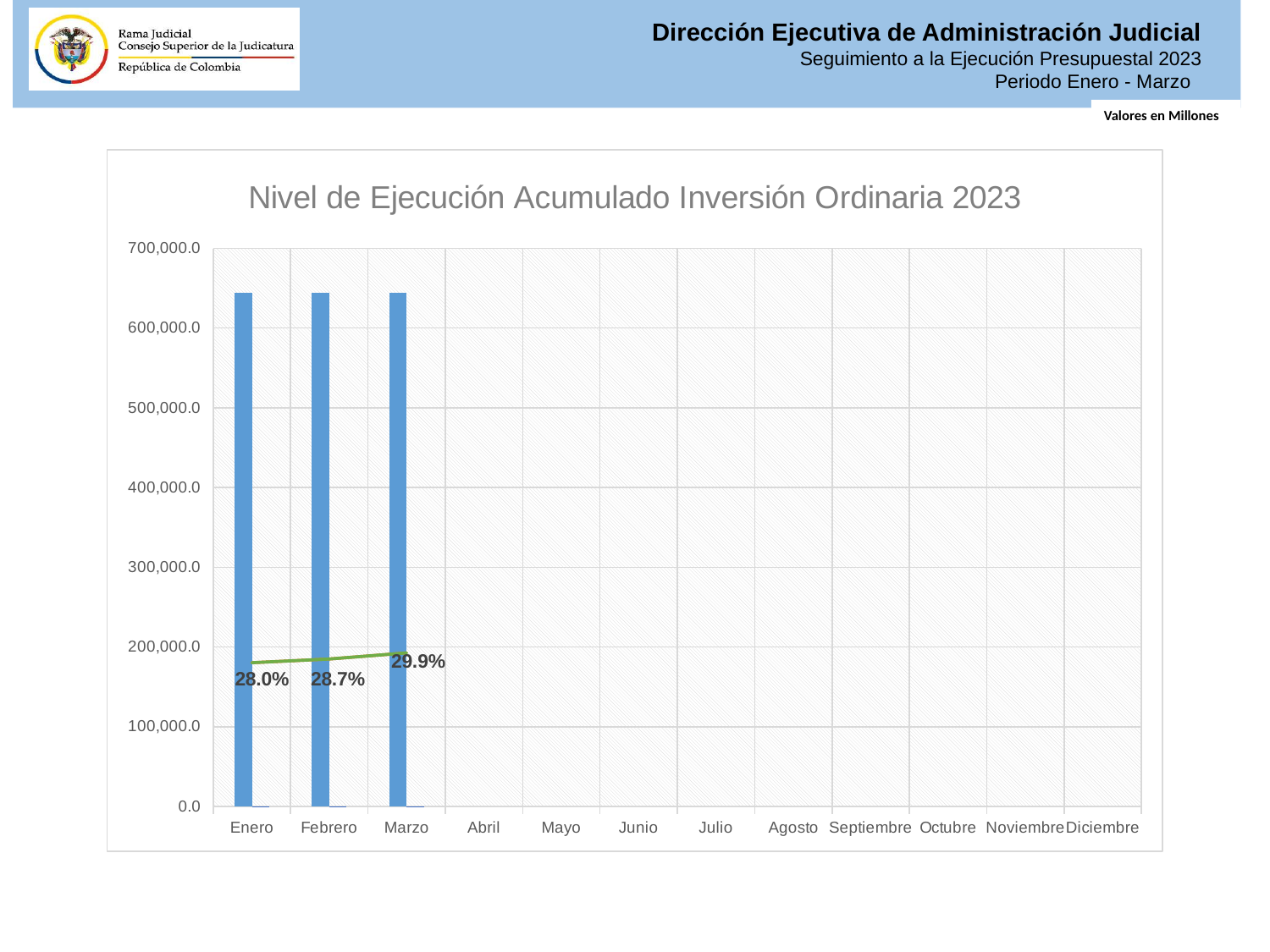
What percentage is labelled on the line for Marzo? 29.9% What is the title of the chart? Nivel de Ejecución Acumulado Inversión Ordinaria 2023 What percentage is labelled on the line for Febrero? 28.7% Which is larger, the percentage for Febrero or the percentage for Marzo? Marzo Do the percentages on the line rise or fall from Enero to Marzo? rise Which month has the lowest percentage labelled on the line? Enero What is the difference in percentage points between the Marzo and Enero line labels? 1.9% What percentage is labelled on the line for Enero? 28.0% How many months are listed along the x axis? 12 Which month has the highest percentage labelled on the line? Marzo Is the value of the bar for Enero greater or less than 600,000.0? greater How many months have a bar plotted? 3